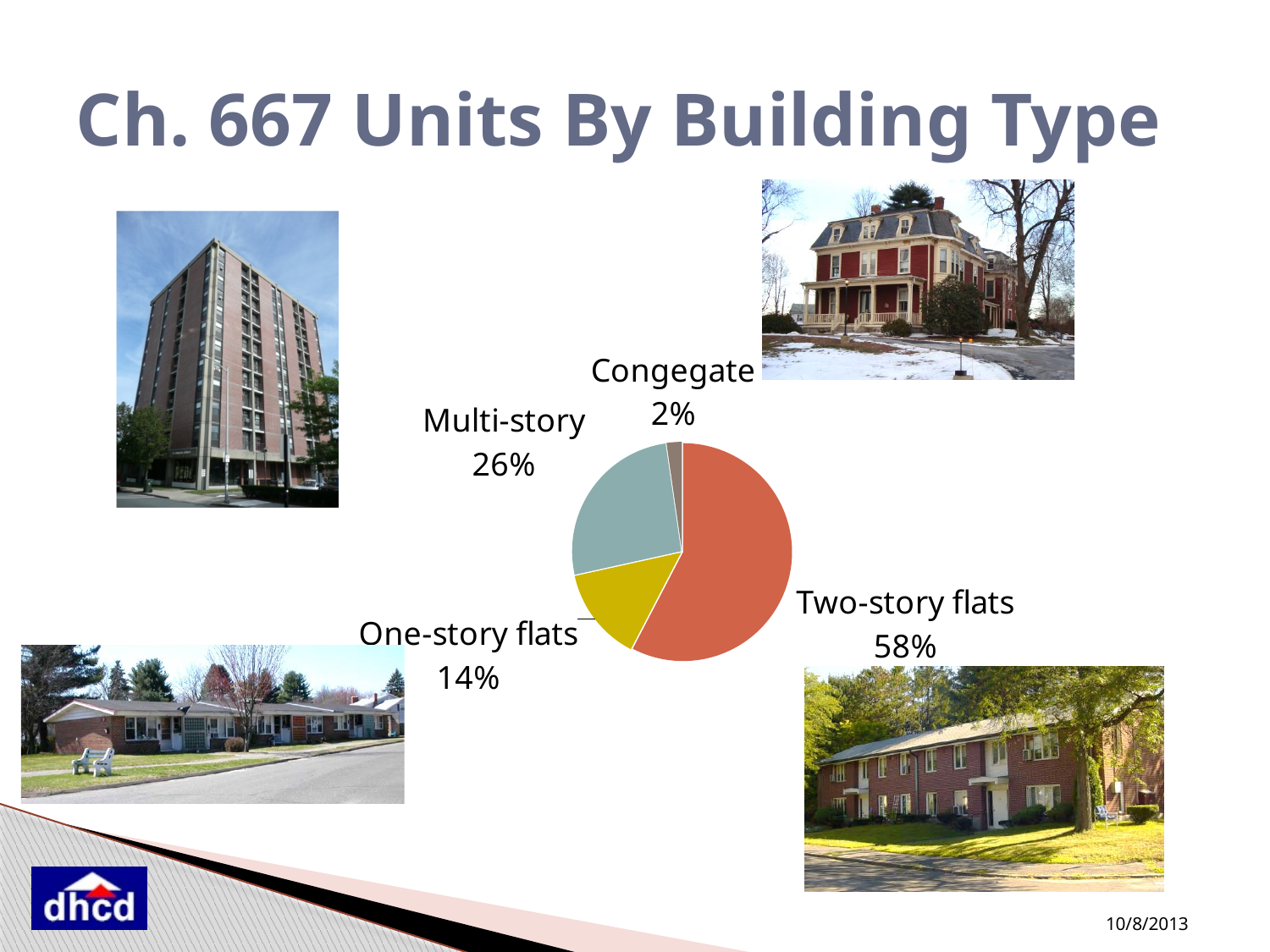
What kind of chart is shown on the slide? Pie chart What share of Ch. 667 units are Multi-story? 26% What share of Ch. 667 units are Two-story flats? 58% What share of Ch. 667 units are Congegate? 2% Which building type has the largest share of units? Two-story flats Which building type has the smallest share of units? Congegate What is the difference in percentage points between Two-story flats and Multi-story? 32 How many building types are shown in the pie chart? 4 Which has a larger share, Multi-story or One-story flats? Multi-story What is the title of the slide containing the chart? Ch. 667 Units By Building Type What is the difference in percentage points between Multi-story and One-story flats? 12